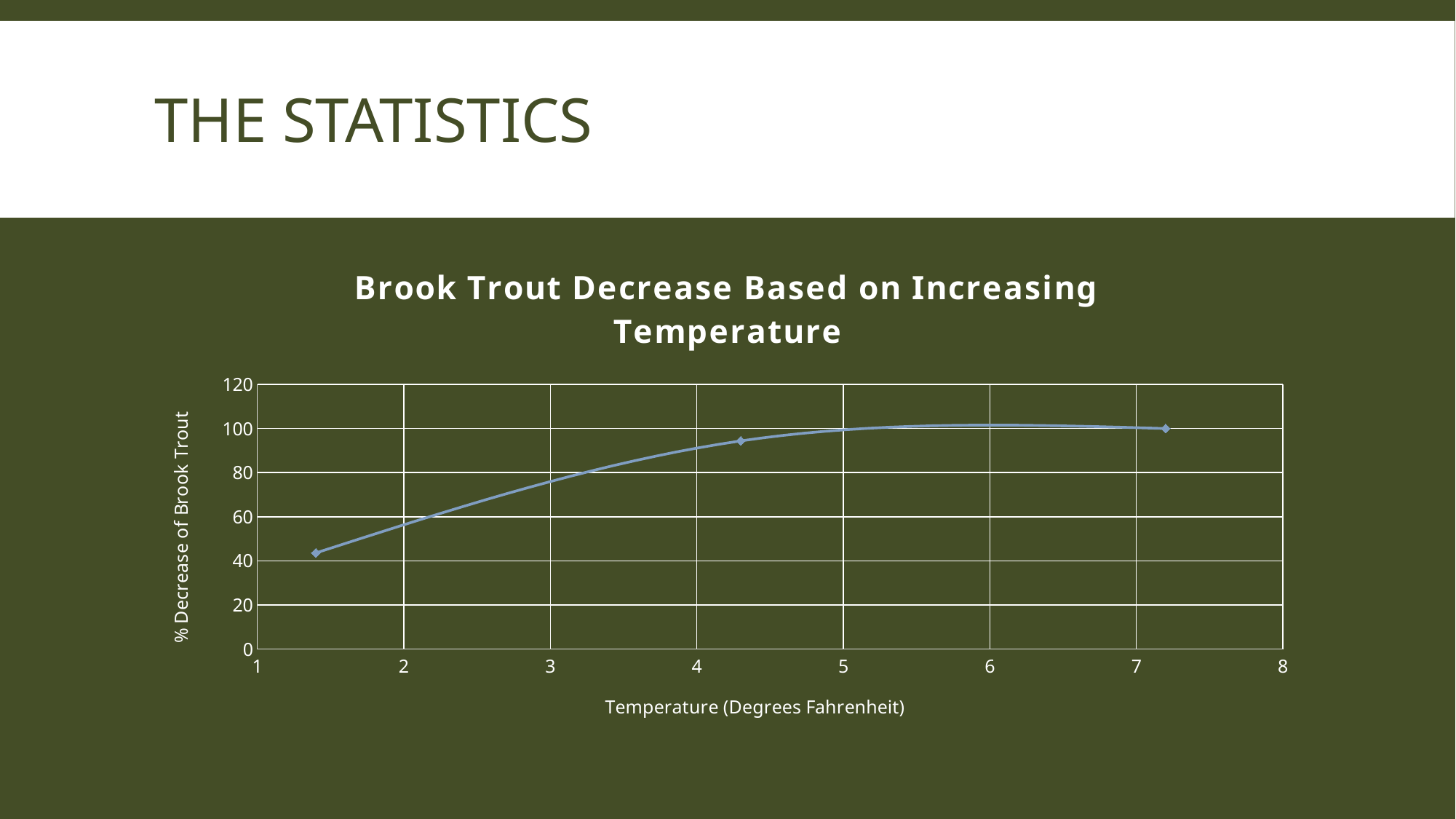
Do the plotted values rise or fall as temperature increases along the x axis? rise How many data points are plotted on the chart? 3 What kind of chart is shown on the slide? line chart Is the value of the rightmost data point greater or less than 80? greater What is the % decrease of brook trout at the rightmost data point? 100 Which is larger, the value of the leftmost data point or the value of the middle data point? the middle data point Is the value of the leftmost data point greater or less than 60? less What is the label of the x axis? Temperature (Degrees Fahrenheit) Is the value of the middle data point greater or less than 80? greater Which data point has the lowest % decrease of brook trout, the leftmost or the rightmost? leftmost What is the title of the chart? Brook Trout Decrease Based on Increasing Temperature